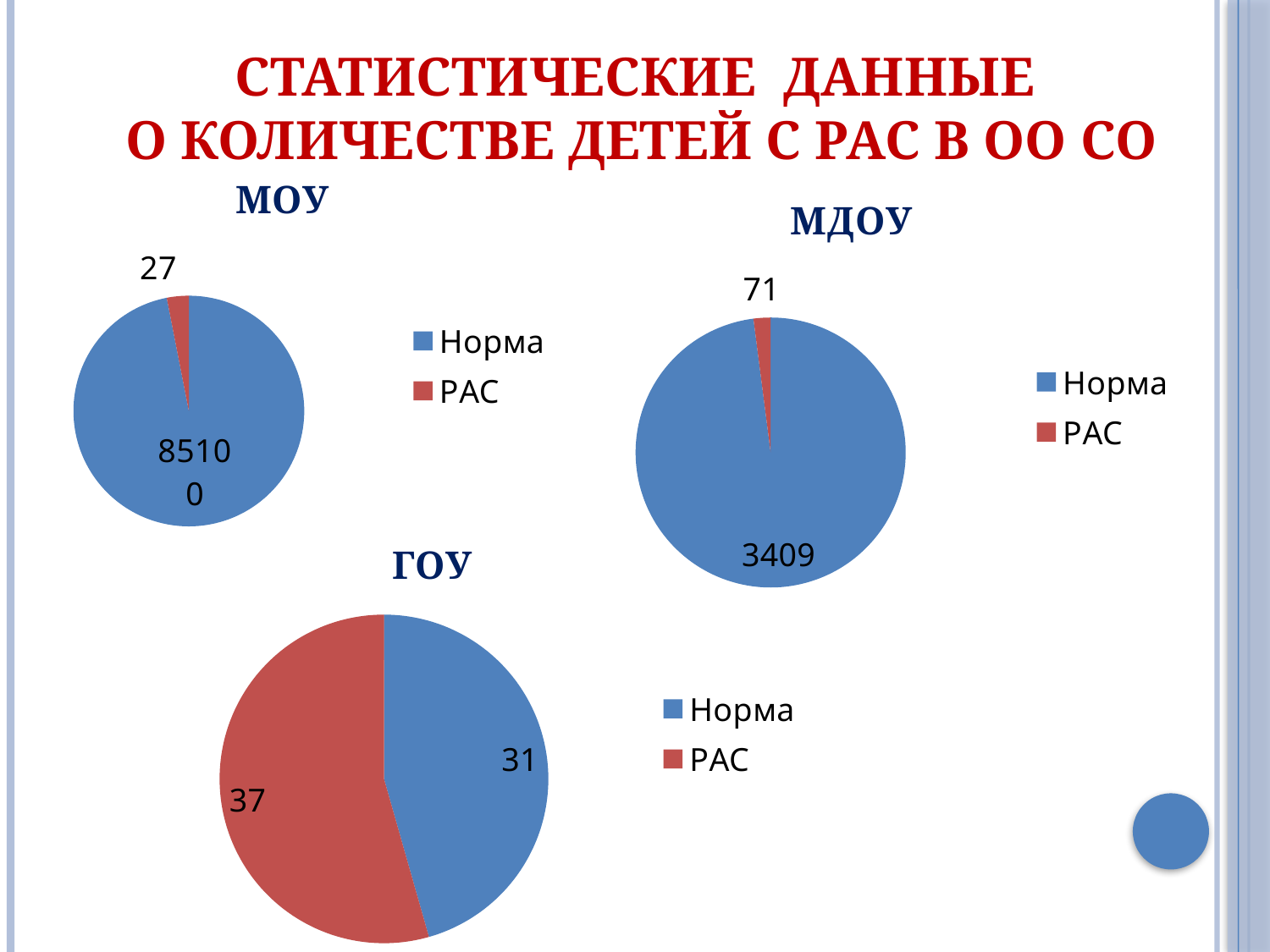
How many charts are shown on the slide? 3 In the ГОУ pie chart, what is the value for Норма? 31 In the ГОУ pie chart, what is the value for РАС? 37 In the МДОУ pie chart, what is the difference between the Норма value and the РАС value? 3338 In the МДОУ pie chart, what is the value for Норма? 3409 In the ГОУ pie chart, which category has the larger slice? РАС In the ГОУ pie chart, what is the difference between the РАС value and the Норма value? 6 In the МДОУ pie chart, what is the value for РАС? 71 In the МОУ pie chart, what is the value for РАС? 27 In the МДОУ pie chart, which category has the smaller slice? РАС Is the РАС value in the МДОУ pie chart larger or smaller than the РАС value in the МОУ pie chart? larger What type of chart is the ГОУ chart? pie chart